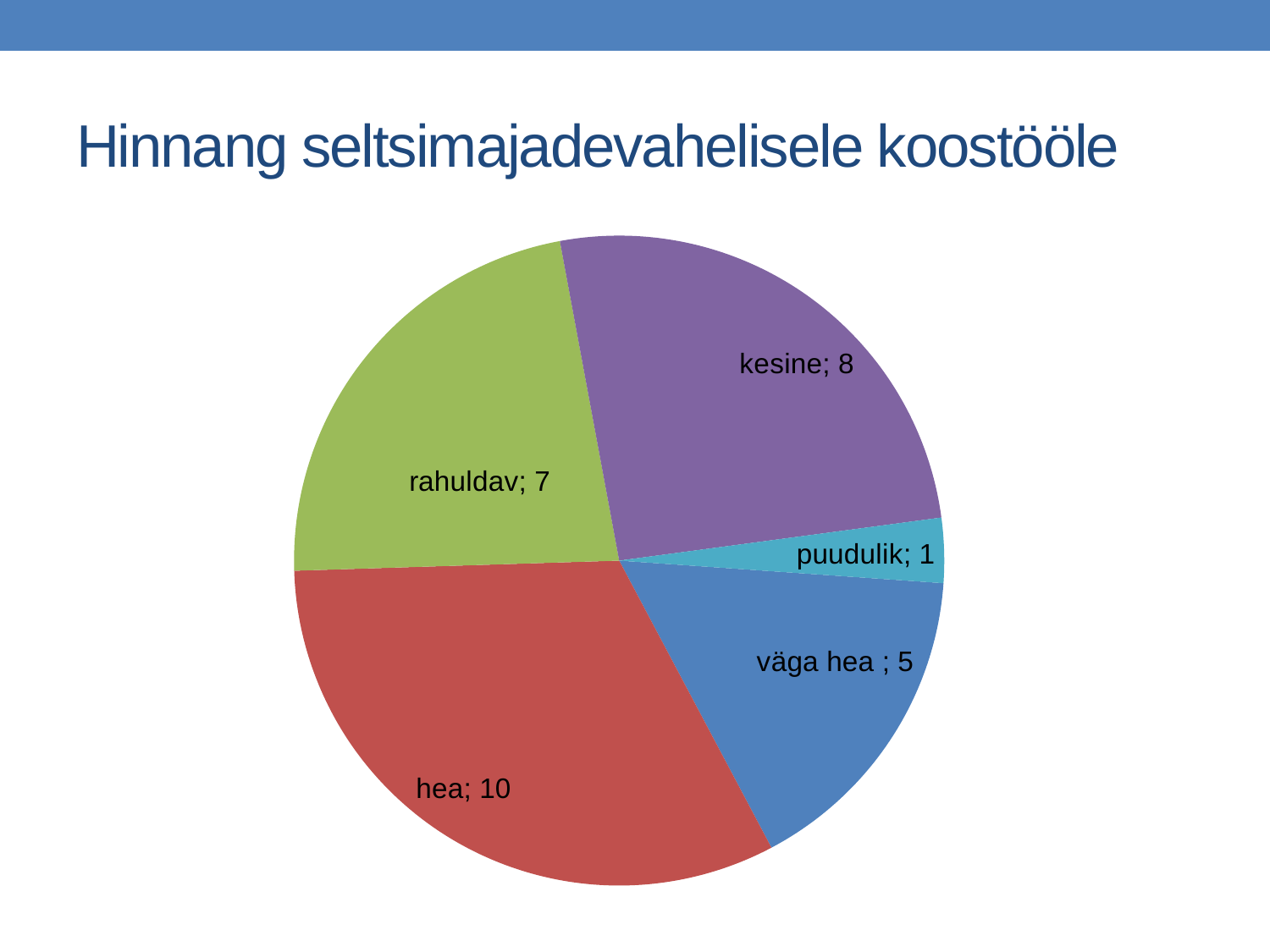
Which is larger, the value for 'kesine' or the value for 'väga hea'? kesine What is the value for the 'hea' slice? 10 What kind of chart is shown on the slide? pie chart What is the difference between the values for 'hea' and 'rahuldav'? 3 What is the value for the 'kesine' slice? 8 Which category has the largest slice of the pie? hea What is the total of all the slice values in the pie chart? 31 Which category has the smallest slice of the pie? puudulik How many slices does the pie chart have? 5 What is the value for the 'puudulik' slice? 1 What is the value for the 'väga hea' slice? 5 What is the title of the chart on the slide? Hinnang seltsimajadevahelisele koostööle